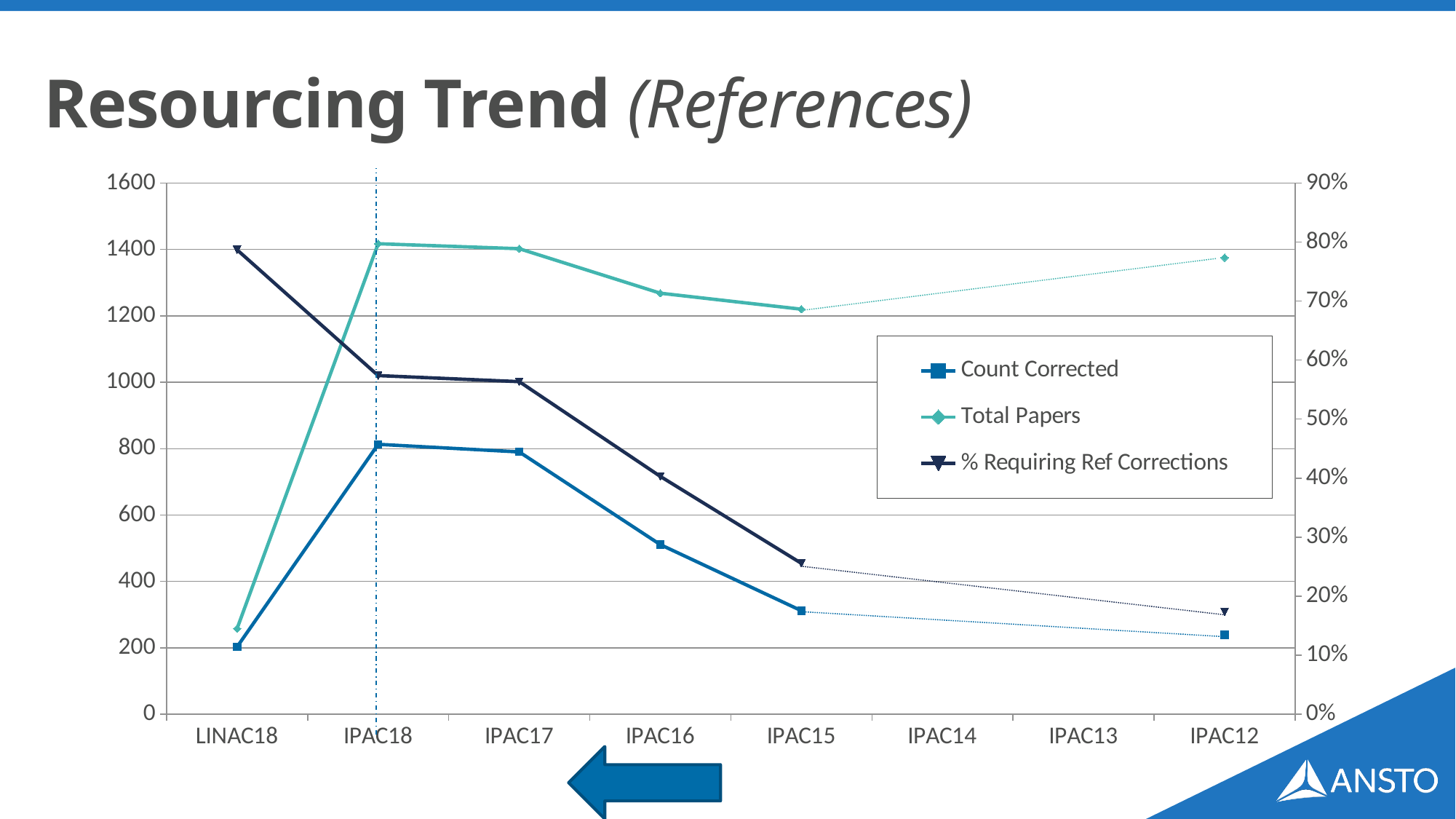
Which category has the highest value for % Requiring Ref Corrections? LINAC18 Is the value for % Requiring Ref Corrections at LINAC18 greater or less than 70%? greater Which is larger, Count Corrected at IPAC16 or Count Corrected at IPAC15? IPAC16 How many categories are labelled on the x axis? 8 Which category has the lowest value for Total Papers? LINAC18 Does Count Corrected rise or fall from IPAC18 to IPAC15? fall Is the value for % Requiring Ref Corrections at IPAC12 greater or less than 20%? less What kind of chart is shown on the slide? line chart Which series is plotted with triangle markers? % Requiring Ref Corrections Is the value for Count Corrected at IPAC16 greater or less than 600? less How many series does the legend list? 3